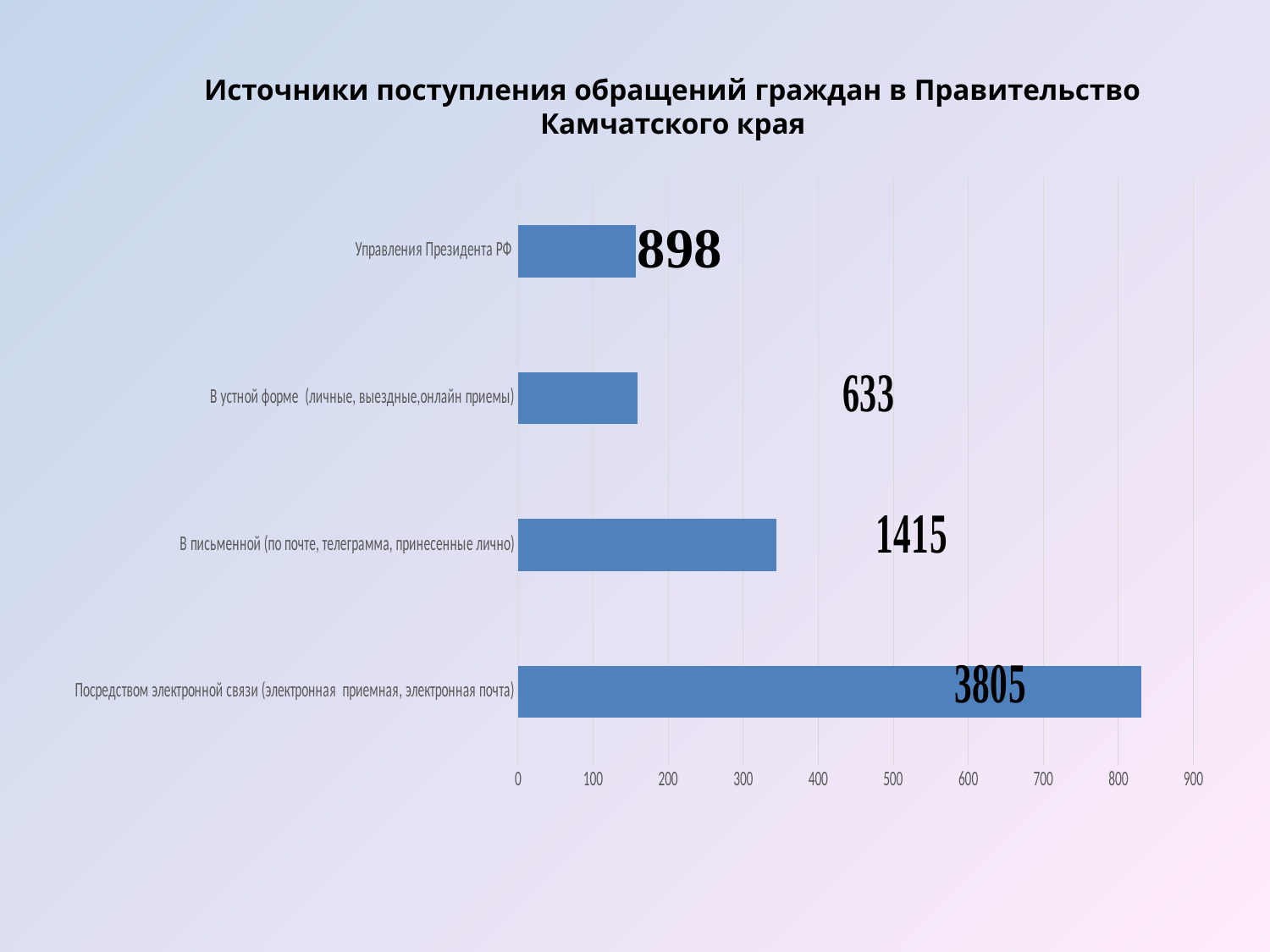
What value is printed for 'Управления Президента РФ'? 898 Which is larger: the value for 'В письменной (по почте, телеграмма, принесенные лично)' or for 'В устной форме (личные, выездные, онлайн приемы)'? В письменной (по почте, телеграмма, принесенные лично) Which source of appeals has the highest value in the chart? Посредством электронной связи (электронная приемная, электронная почта) Is the bar for 'Посредством электронной связи (электронная приемная, электронная почта)' greater or less than 800 on the axis? greater What value is printed for 'Посредством электронной связи (электронная приемная, электронная почта)'? 3805 What value is printed for 'В письменной (по почте, телеграмма, принесенные лично)'? 1415 What is the title of the chart? Источники поступления обращений граждан в Правительство Камчатского края Is the bar for 'В устной форме (личные, выездные, онлайн приемы)' greater or less than 200 on the axis? less What kind of chart is shown on the slide? bar chart What is the difference between the printed values for 'Посредством электронной связи' and 'В письменной'? 2390 What value is printed for 'В устной форме (личные, выездные, онлайн приемы)'? 633 How many categories (sources of appeals) are shown in the chart? 4